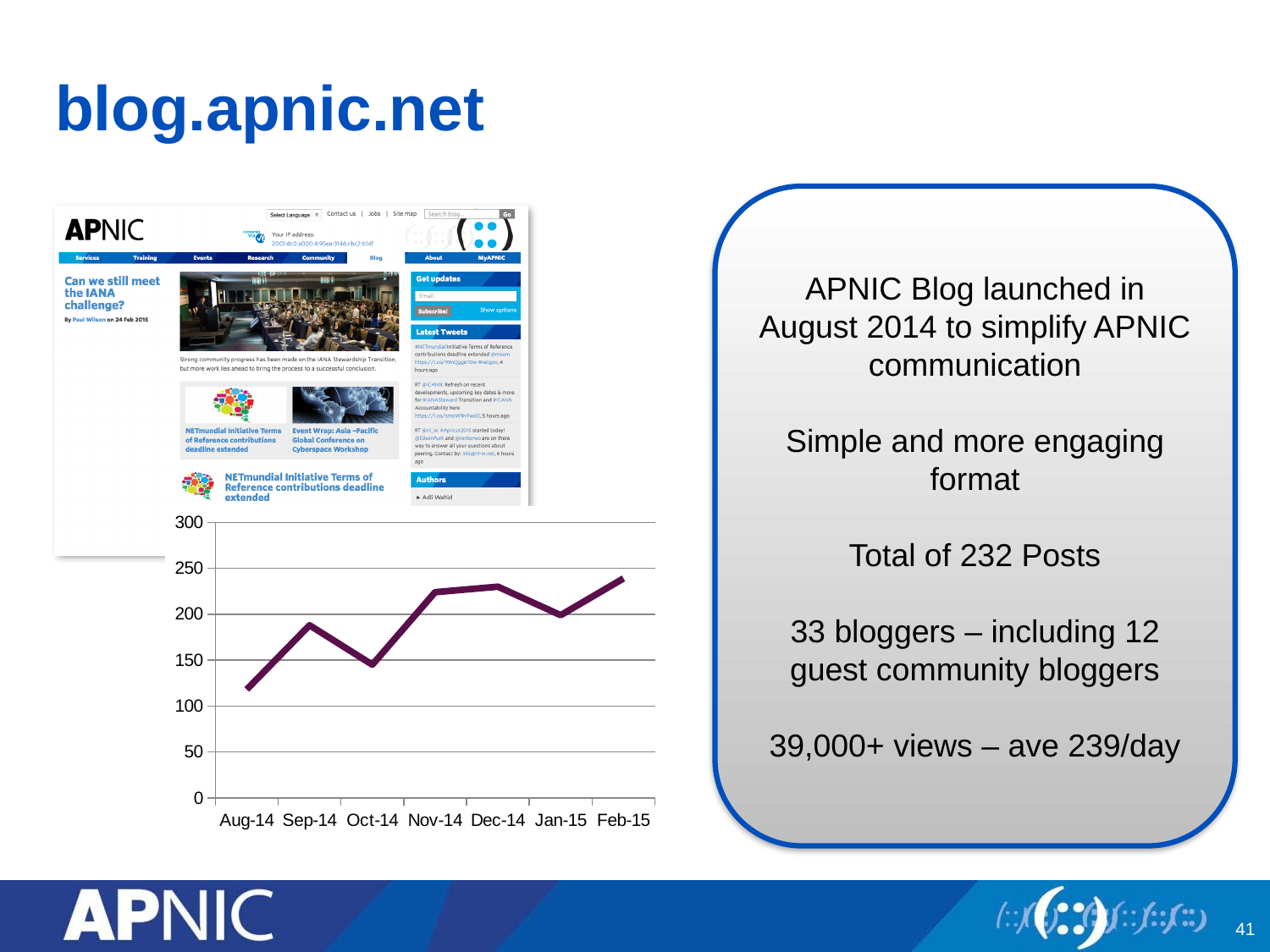
Is the value for Sep-14 greater or less than 150? greater How many months are plotted along the x axis of the chart? 7 Is the value for Nov-14 greater or less than 200? greater Is the value for Feb-15 greater or less than 200? greater What kind of chart is shown on the slide? line chart Does the line rise or fall from Aug-14 to Sep-14? rise Which is larger, the value for Sep-14 or the value for Oct-14? Sep-14 Which month has the lowest value on the chart? Aug-14 What is the highest value shown on the y axis of the chart? 300 Does the line rise or fall from Sep-14 to Oct-14? fall Which is larger, the value for Nov-14 or the value for Jan-15? Nov-14